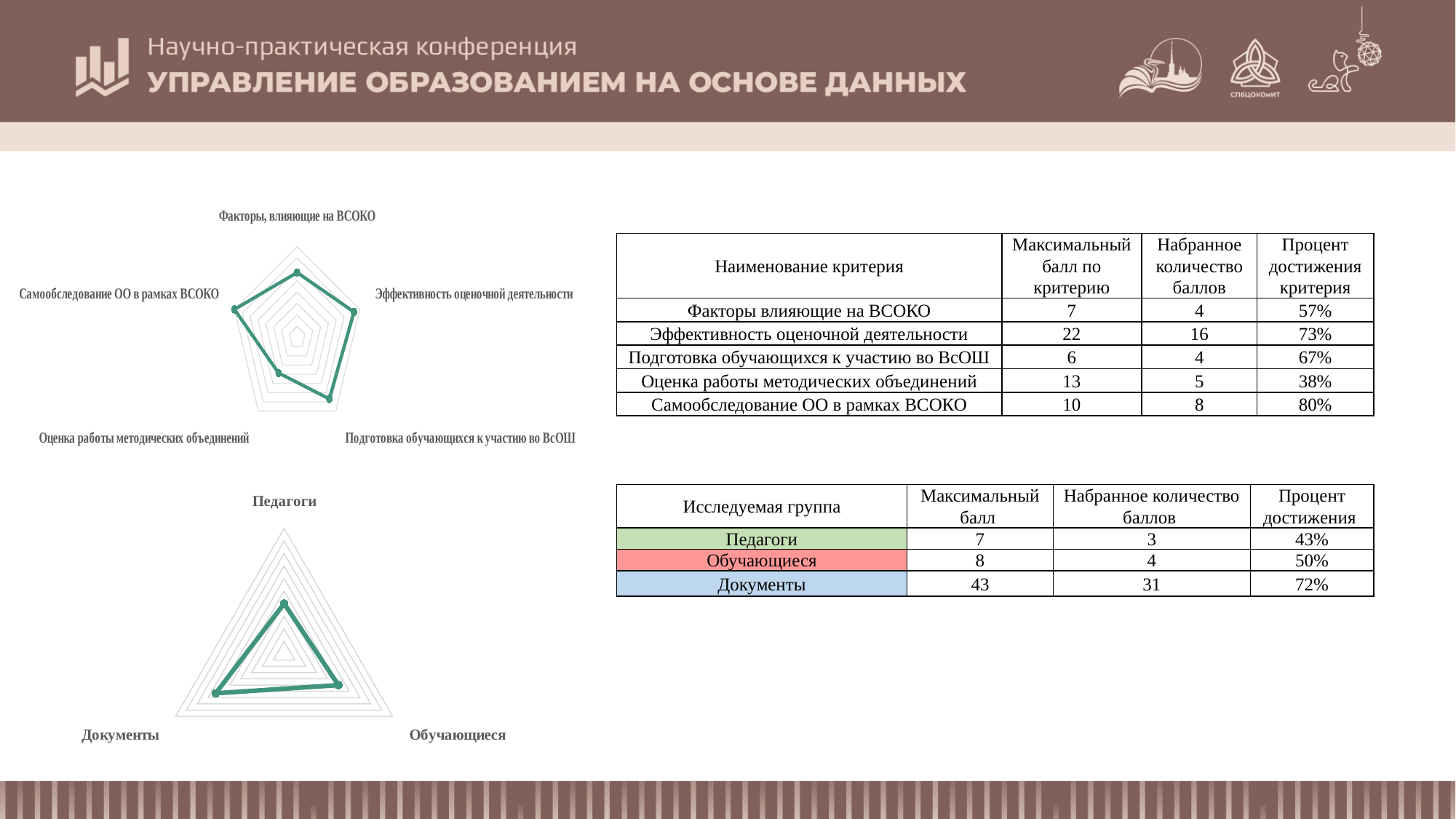
In the upper radar chart, which category has the lowest value? Оценка работы методических объединений In the lower radar chart, which category has the highest value? Документы In the lower radar chart, which category has the lowest value? Педагоги According to the table next to the lower radar chart, what is the percentage for Документы? 72% What kind of chart is the upper chart on the left of the slide? Radar chart What kind of chart is the lower chart on the left of the slide? Radar chart In the upper radar chart, which category has the highest value? Самообследование ОО в рамках ВСОКО In the upper radar chart, which is larger: the value for Эффективность оценочной деятельности or the value for Оценка работы методических объединений? Эффективность оценочной деятельности In the lower radar chart, which is larger: the value for Документы or the value for Обучающиеся? Документы How many categories (axes) does the lower radar chart have? 3 According to the table next to the upper radar chart, what is the percentage for Самообследование ОО в рамках ВСОКО? 80% How many categories (axes) does the upper radar chart have? 5